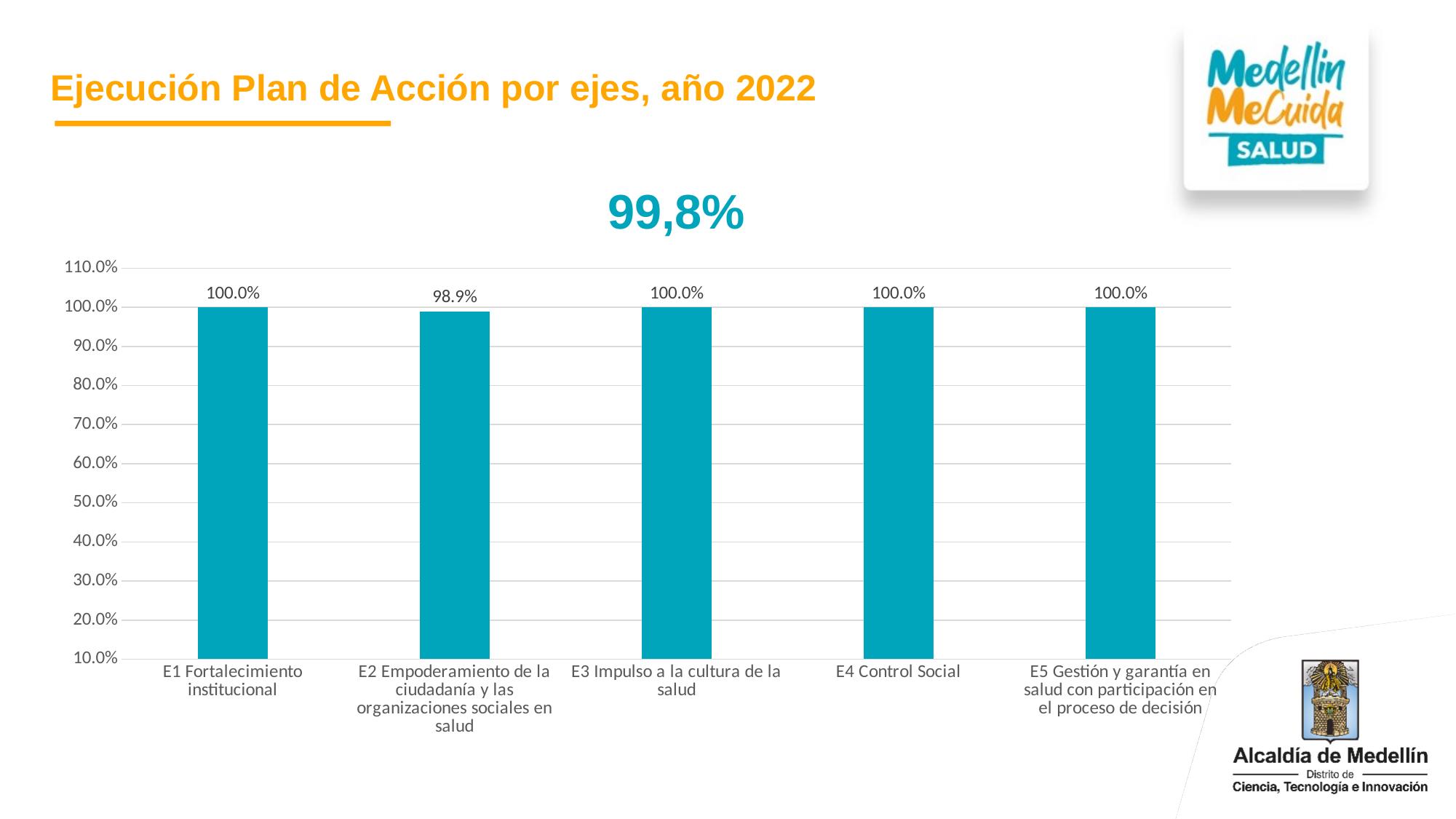
What is the value for E1 Fortalecimiento institucional? 100.0% What is the value for E3 Impulso a la cultura de la salud? 100.0% Which is larger, the value for E2 Empoderamiento de la ciudadanía y las organizaciones sociales en salud or the value for E5 Gestión y garantía en salud con participación en el proceso de decisión? E5 Gestión y garantía en salud con participación en el proceso de decisión What is the value for E4 Control Social? 100.0% Which category has the lowest value? E2 Empoderamiento de la ciudadanía y las organizaciones sociales en salud Is the value for E2 Empoderamiento de la ciudadanía y las organizaciones sociales en salud greater or less than 90.0%? greater What kind of chart is shown on the slide? bar chart How many categories are shown on the x axis? 5 What is the difference between the value for E1 Fortalecimiento institucional and the value for E2 Empoderamiento de la ciudadanía y las organizaciones sociales en salud? 1.1% What is the value for E2 Empoderamiento de la ciudadanía y las organizaciones sociales en salud? 98.9% What large percentage figure is printed above the chart? 99,8% What is the title of the slide containing the chart? Ejecución Plan de Acción por ejes, año 2022